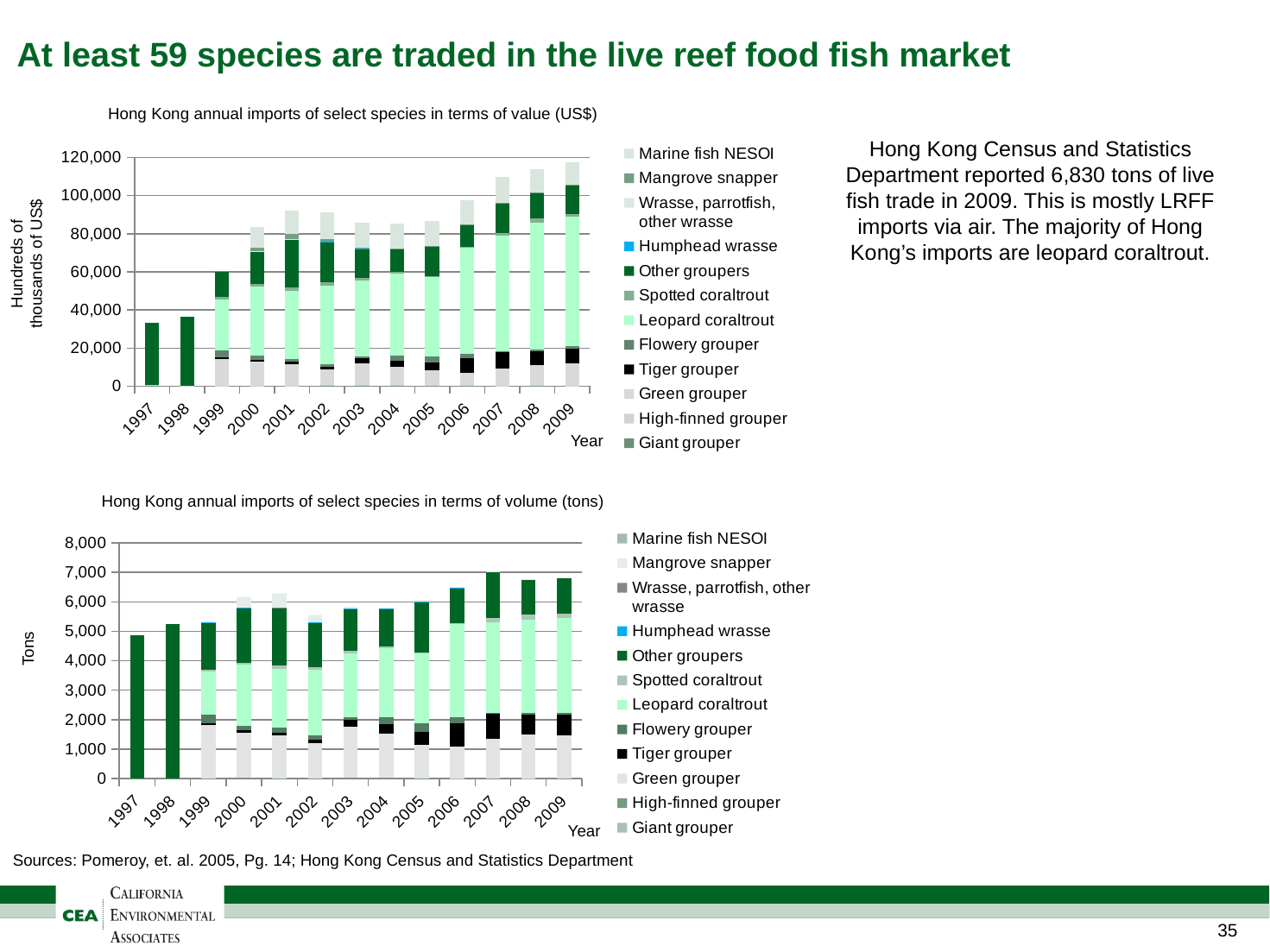
What kind of chart is the top chart, 'Hong Kong annual imports of select species in terms of value (US$)'? Stacked bar chart In the bottom chart (imports in terms of volume), which year has the larger total bar, 2000 or 2002? 2000 In the top chart (imports in terms of value), do the total bars generally rise or fall from 1997 to 2009? rise In the top chart (imports in terms of value), how many series does the legend list? 12 What is the y-axis label of the bottom chart (imports in terms of volume)? Tons In the bottom chart (imports in terms of volume), which year has the highest total bar? 2007 In the top chart (imports in terms of value), is the total for 1999 greater or less than 80,000? less In the top chart (imports in terms of value), how many years are shown on the x axis? 13 In the top chart (imports in terms of value), is the total for 2009 greater or less than 100,000? greater In the top chart (imports in terms of value), which year has the highest total bar? 2009 In the top chart (imports in terms of value), which year has the lowest total bar? 1997 In the bottom chart (imports in terms of volume), is the total for 1997 greater or less than 5,000? less